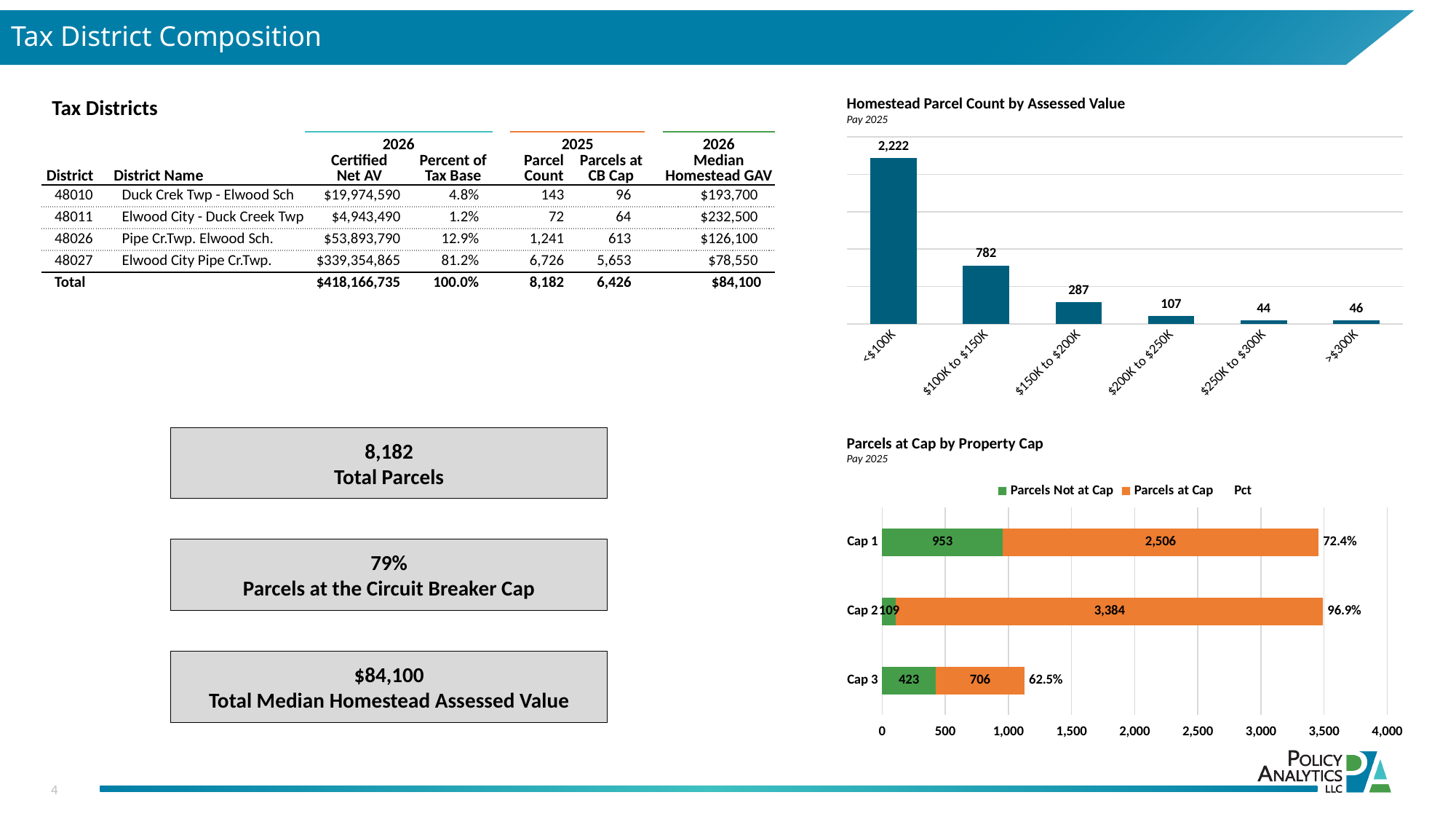
How many entries does the legend of the 'Parcels at Cap by Property Cap' chart list? 3 How many categories are shown in the 'Homestead Parcel Count by Assessed Value' chart? 6 In the 'Parcels at Cap by Property Cap' chart, what is the Parcels at Cap value for Cap 2? 3,384 In the 'Homestead Parcel Count by Assessed Value' chart, which category has the lowest value? $250K to $300K In the 'Parcels at Cap by Property Cap' chart, which is larger: Parcels Not at Cap for Cap 1 or for Cap 3? Cap 1 In the 'Parcels at Cap by Property Cap' chart, what is the Pct value for Cap 3? 62.5% In the 'Homestead Parcel Count by Assessed Value' chart, what is the difference between the <$100K and $100K to $150K values? 1,440 In the 'Homestead Parcel Count by Assessed Value' chart, what is the value for the <$100K category? 2,222 What kind of chart is 'Homestead Parcel Count by Assessed Value'? Bar chart In the 'Homestead Parcel Count by Assessed Value' chart, what is the value for $150K to $200K? 287 In the 'Parcels at Cap by Property Cap' chart, what is the total of the Cap 1 stacked bar? 3,459 In the 'Homestead Parcel Count by Assessed Value' chart, which category has the highest value? <$100K